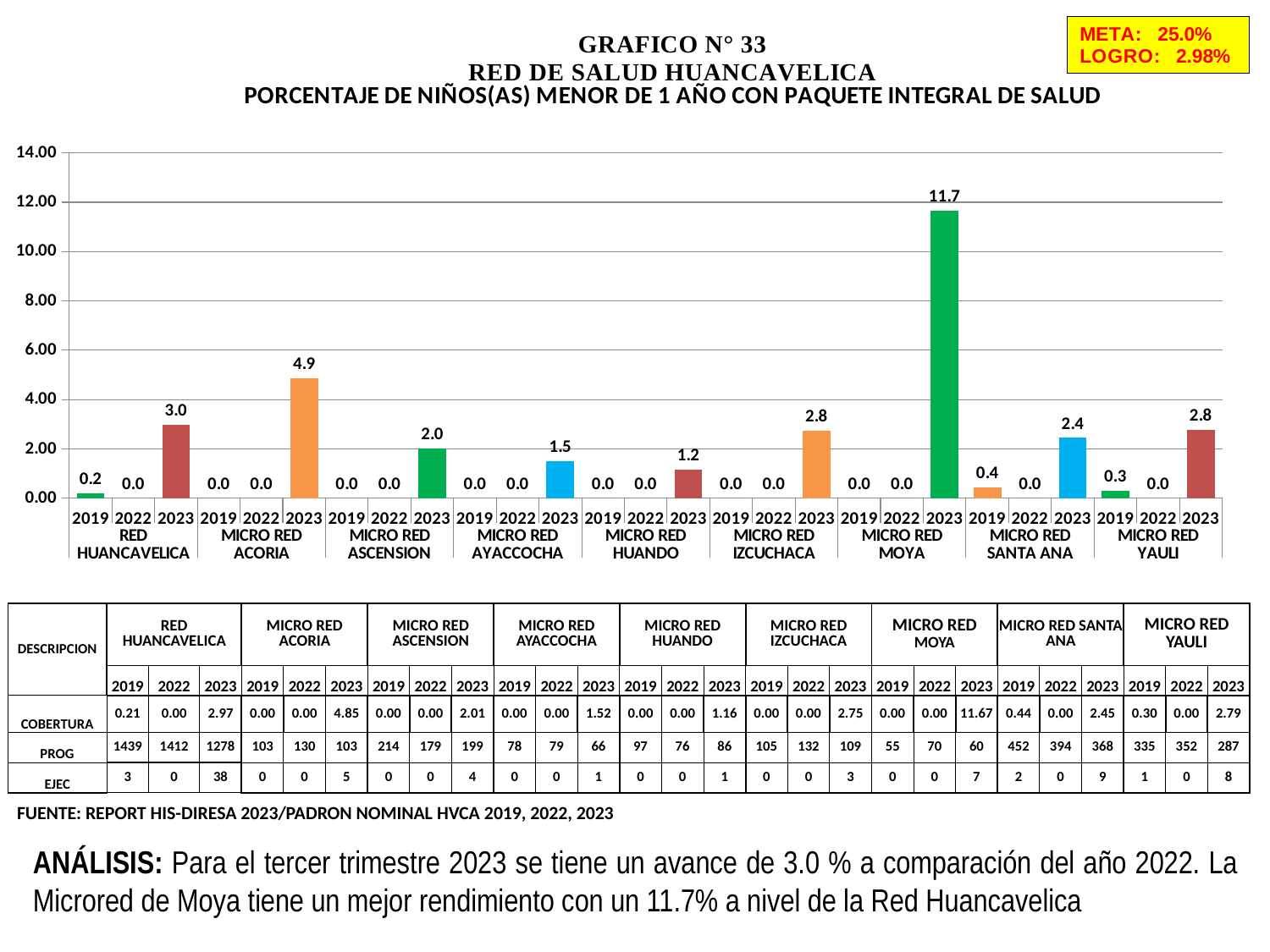
How many health networks (red / micro red groups) are shown on the x axis? 9 What is the number of the graphic shown in the chart title? GRAFICO N° 33 Is the 2023 value for MICRO RED MOYA greater or less than 10.00? greater Which micro red has the highest value in 2023? MICRO RED MOYA What is the value for MICRO RED ACORIA in 2023? 4.9 Which is larger, the 2023 value for MICRO RED ACORIA or the 2023 value for MICRO RED IZCUCHACA? MICRO RED ACORIA For MICRO RED YAULI, does the value rise or fall from 2022 to 2023? rise What is the value for RED HUANCAVELICA in 2023? 3.0 What kind of chart is shown on the slide? bar chart What is the value for MICRO RED SANTA ANA in 2019? 0.4 What is the value for MICRO RED MOYA in 2023? 11.7 What is the difference between the 2023 values for MICRO RED MOYA and MICRO RED ACORIA? 6.8